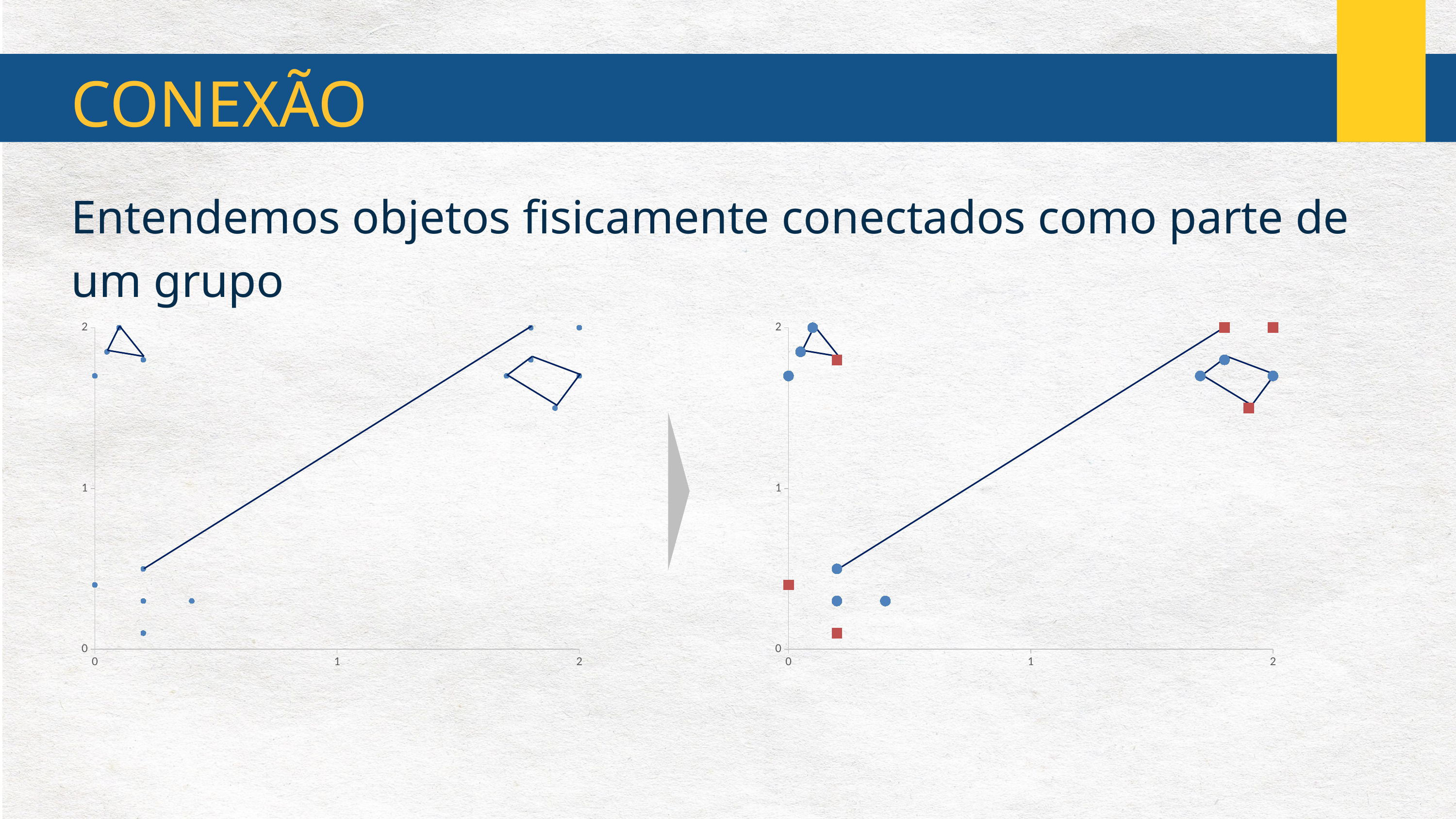
What kind of chart is the right chart on the slide? scatter chart On the left chart, what is the highest value shown on the x axis? 2 On the left chart, is the y value of the lowest plotted point greater or less than 1? less On the right chart, how many blue circle markers are there? 9 On the left chart, how many points are plotted in total? 15 On the right chart, how many different marker shapes are used for the points? 2 On the right chart, what is the highest value shown on the y axis? 2 On the left chart, how many points lie below the y-axis value of 1? 5 What kind of chart is the left chart on the slide? scatter chart On the right chart, does the long diagonal line rise or fall as x increases? rise